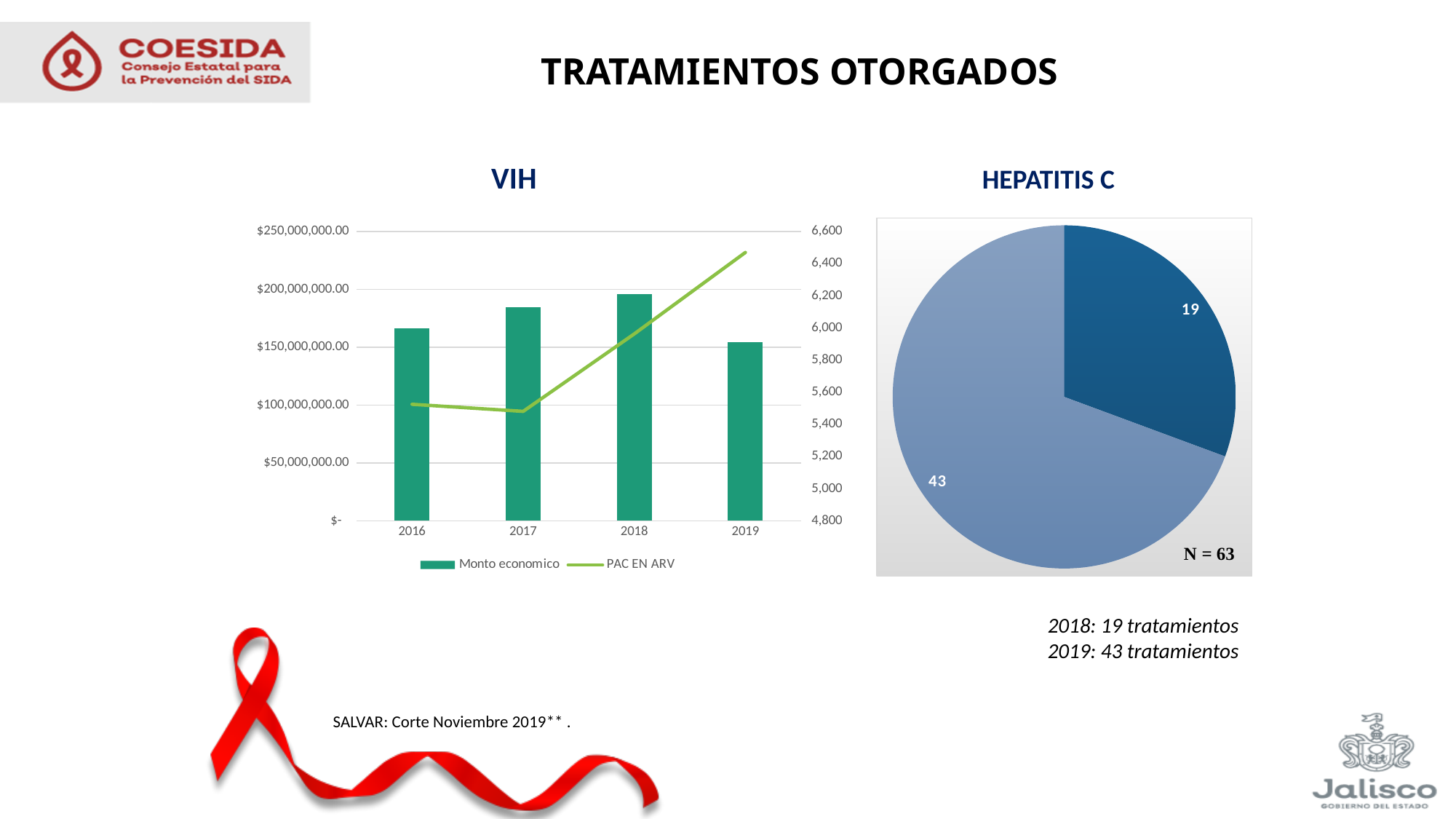
What kind of chart is the VIH chart? A bar chart combined with a line chart In the HEPATITIS C chart, what value is labeled on the dark blue slice? 19 In the VIH chart, is the PAC EN ARV value for 2019 greater or less than 6,200? greater In the VIH chart, does the PAC EN ARV line rise or fall from 2017 to 2019? Rises In the VIH chart, how many series does the legend list? 2 In the VIH chart, is the Monto economico value for 2019 greater or less than $200,000,000.00? less In the VIH chart, which year has the shortest Monto economico bar? 2019 In the HEPATITIS C chart, what is the difference between the two slice values, 43 and 19? 24 In the VIH chart, is the Monto economico value for 2016 greater or less than $150,000,000.00? greater In the VIH chart, which year has the tallest Monto economico bar? 2018 What kind of chart is the HEPATITIS C chart? Pie chart In the VIH chart, how many years are shown on the x axis? 4